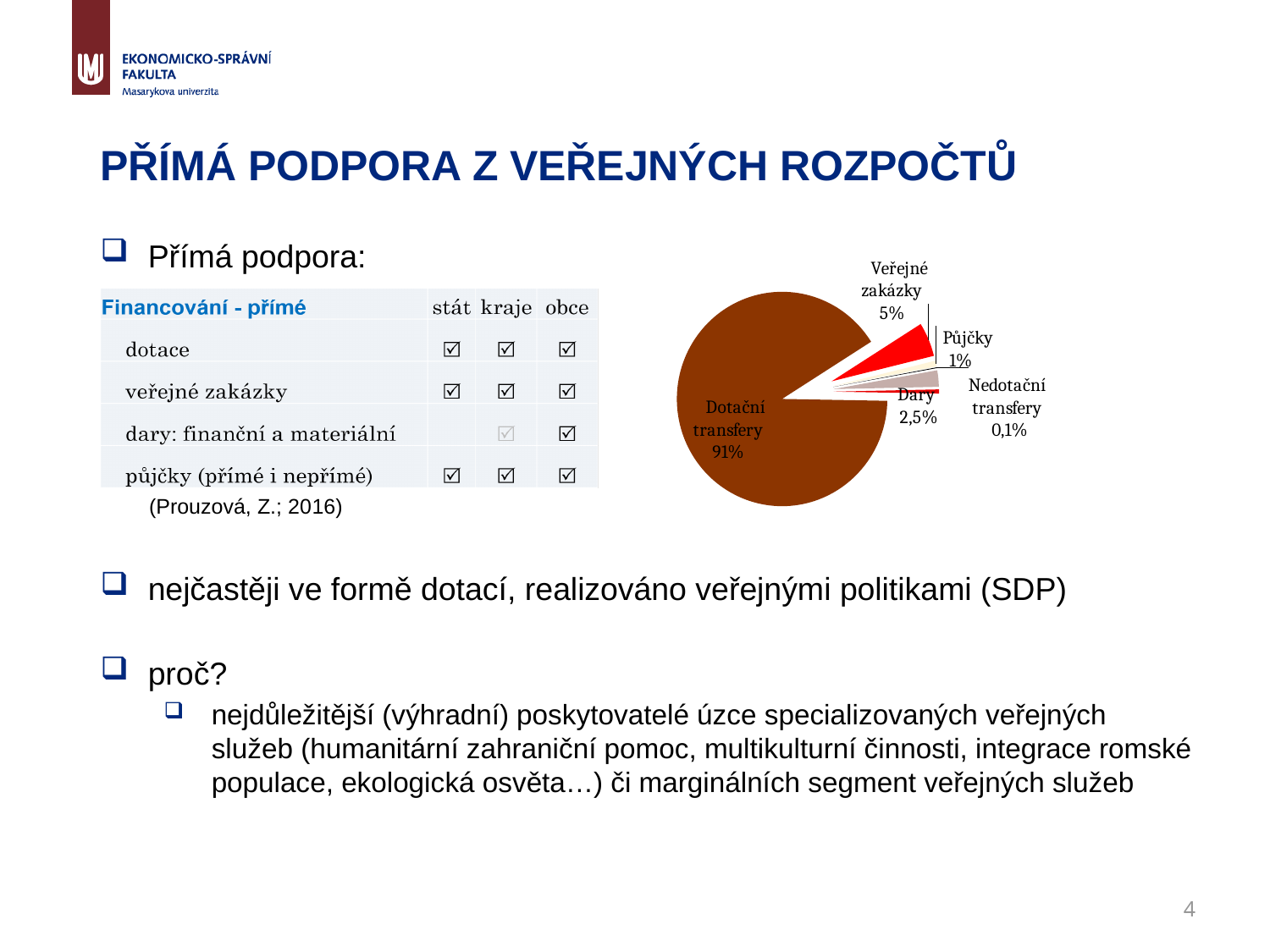
Which is larger in the pie chart, Veřejné zakázky or Dary? Veřejné zakázky What share of the pie does Dotační transfery have? 91% Which slice of the pie chart is the largest? Dotační transfery What is the difference in percentage points between Veřejné zakázky and Půjčky? 4 What share of the pie does Půjčky have? 1% What kind of chart is shown on the slide? pie chart How many slices does the pie chart have? 6 What share of the pie does Veřejné zakázky have? 5% What share of the pie does Nedotační transfery have? 0,1% What share of the pie does Dary have? 2,5% Which slice of the pie chart is the smallest? Nedotační transfery What colour is the Dotační transfery slice of the pie chart? brown